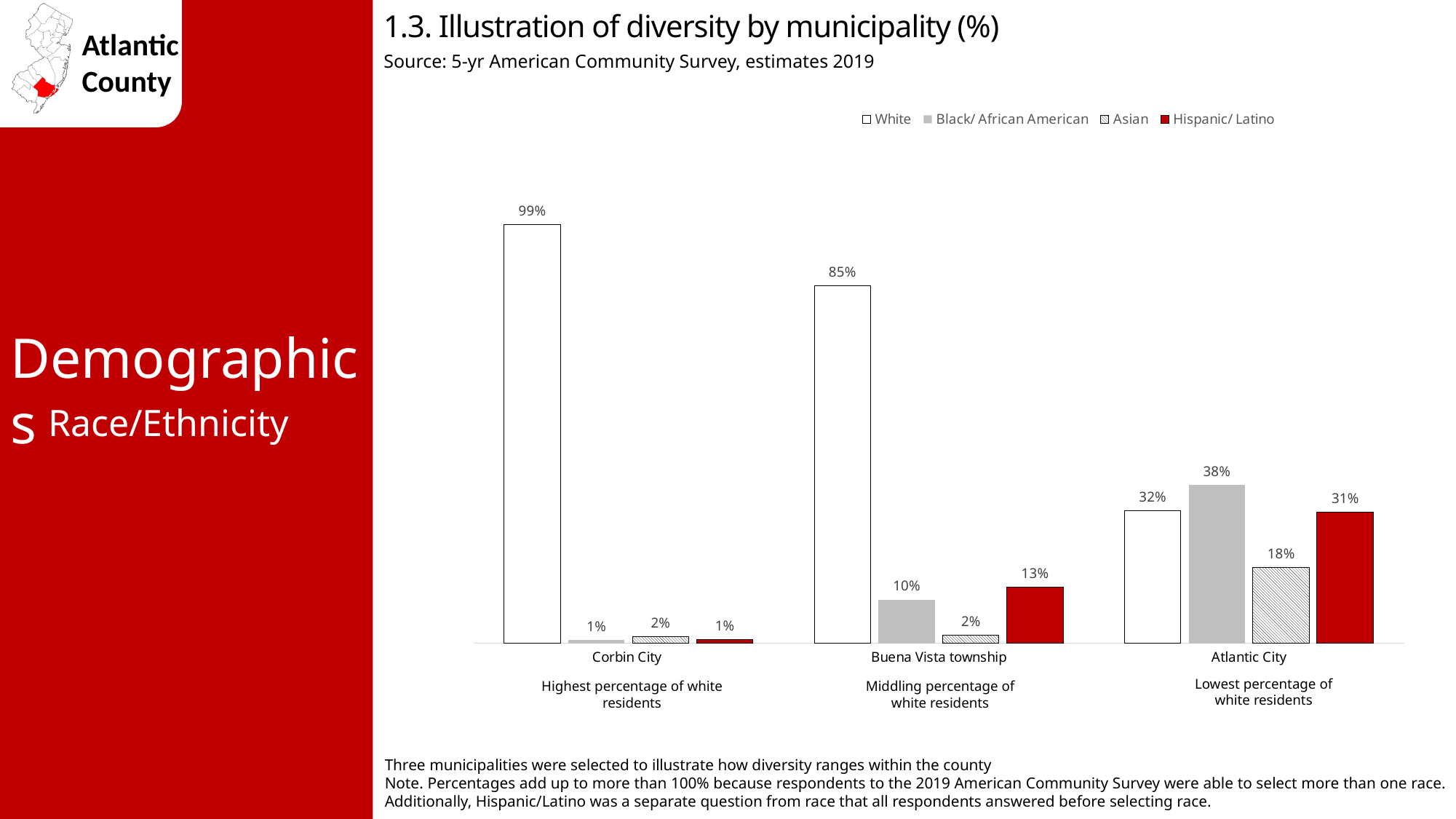
How many municipalities are shown on the chart? 3 How many series does the legend list? 4 What is the Asian percentage for Atlantic City? 18% What is the difference between the White percentages of Corbin City and Buena Vista township? 14% What is the White percentage for Corbin City? 99% In Atlantic City, which is larger: the Black/ African American percentage or the White percentage? Black/ African American What colour are the Hispanic/ Latino bars? Red What is the Black/ African American percentage for Atlantic City? 38% What kind of chart is shown on the slide? Bar chart What is the Hispanic/ Latino percentage for Buena Vista township? 13% Which municipality has the highest White percentage? Corbin City Which municipality has the lowest Hispanic/ Latino percentage? Corbin City